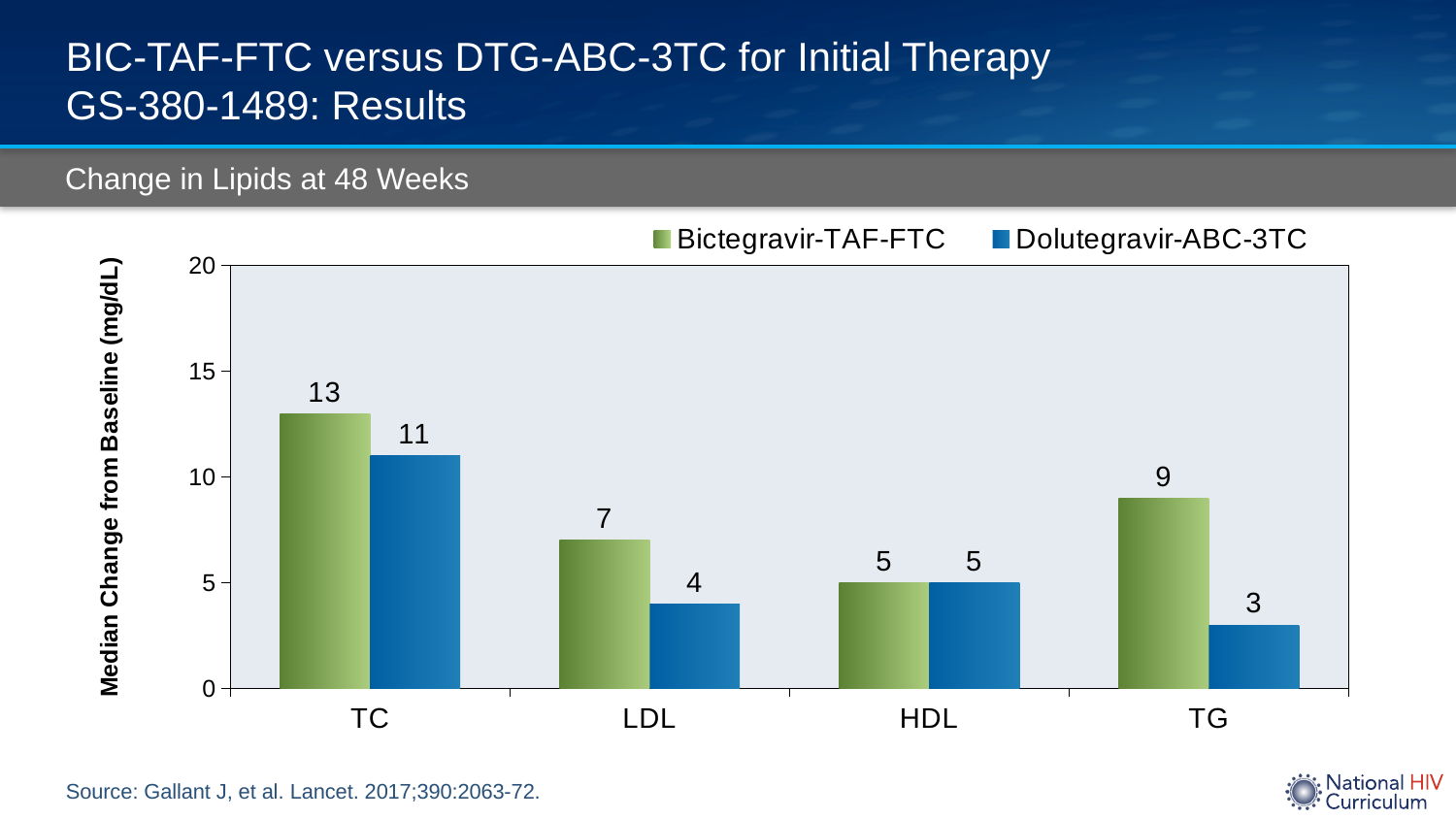
Which lipid category has the highest value for Dolutegravir-ABC-3TC? TC Which lipid category has the lowest value for Dolutegravir-ABC-3TC? TG Which series has the larger value for LDL, Bictegravir-TAF-FTC or Dolutegravir-ABC-3TC? Bictegravir-TAF-FTC What is the median change from baseline in TG for Bictegravir-TAF-FTC? 9 What kind of chart is shown on the slide? Bar chart What is the median change from baseline in TC for Bictegravir-TAF-FTC? 13 What is the median change from baseline in LDL for Dolutegravir-ABC-3TC? 4 What is the difference between the Bictegravir-TAF-FTC and Dolutegravir-ABC-3TC values for TG? 6 How many lipid categories are shown on the x axis? 4 What is the difference between the Bictegravir-TAF-FTC and Dolutegravir-ABC-3TC values for TC? 2 How many series does the legend list? 2 What is the label of the y axis? Median Change from Baseline (mg/dL)